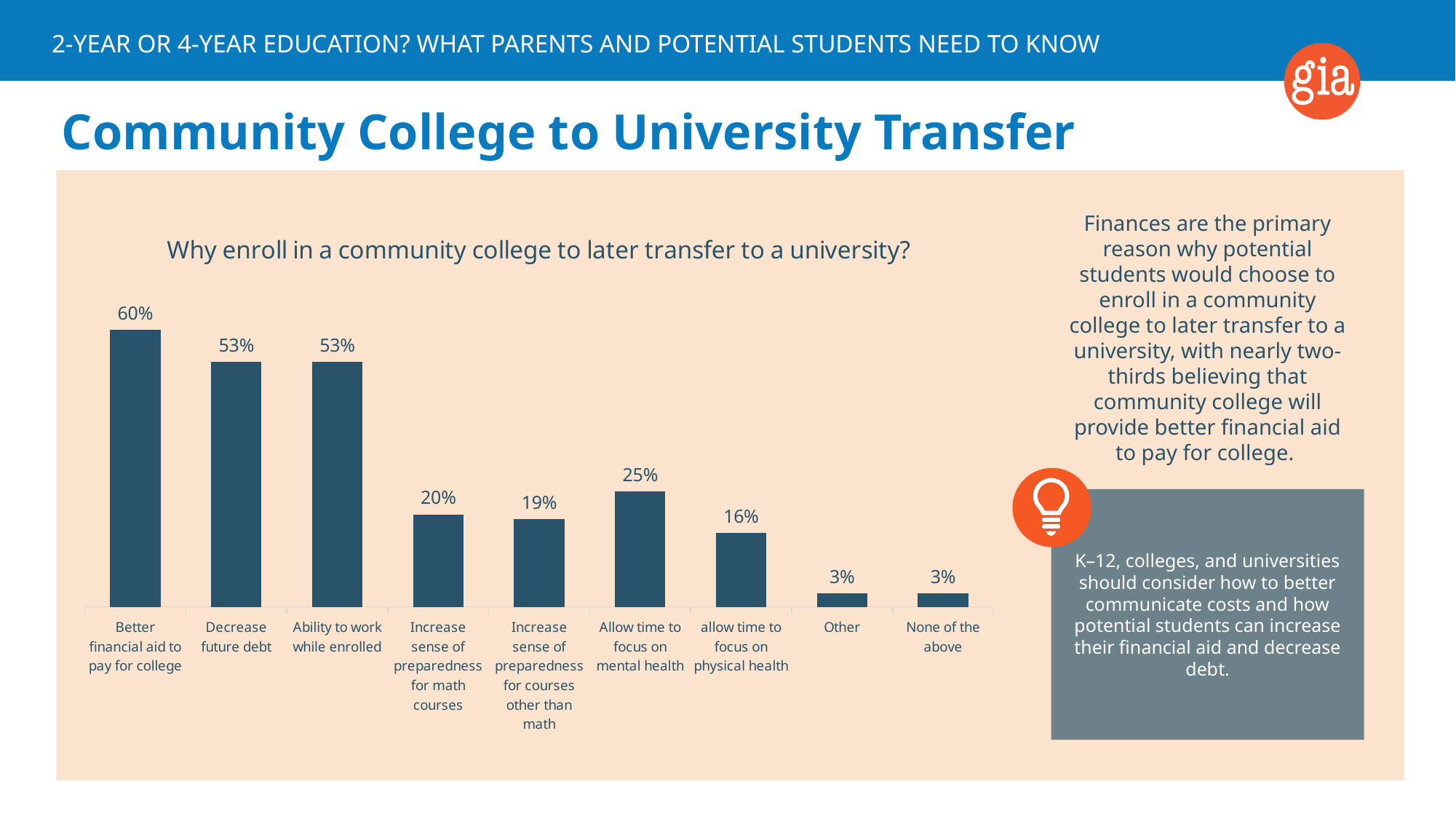
What is the value for "Allow time to focus on mental health"? 25% What is the difference between "Better financial aid to pay for college" and "Decrease future debt"? 7% What kind of chart is shown on the slide? Bar chart Which category has the highest value? Better financial aid to pay for college How many categories are shown in the chart? 9 What is the difference between "Allow time to focus on mental health" and "allow time to focus on physical health"? 9% What is the value for "Ability to work while enrolled"? 53% What is the value for "Better financial aid to pay for college"? 60% What is the title of the chart? Why enroll in a community college to later transfer to a university? Which is larger, "Increase sense of preparedness for math courses" or "Allow time to focus on mental health"? Allow time to focus on mental health What is the value for "Other"? 3% What is the value for "Increase sense of preparedness for courses other than math"? 19%